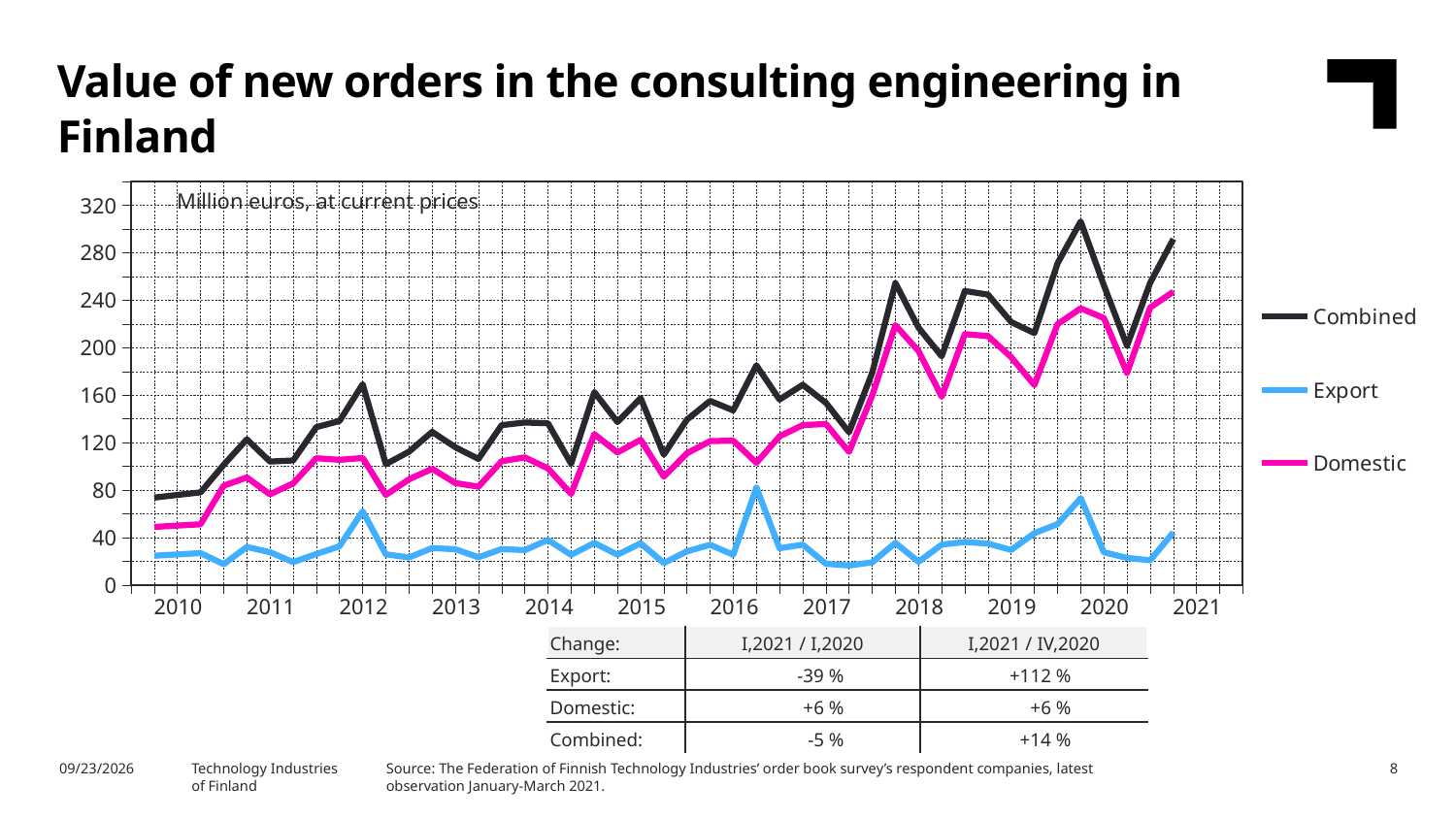
What unit is stated at the top of the chart? Million euros, at current prices How many series does the chart legend list? 3 Overall, does the Combined series rise or fall from 2010 to 2021? rise In 2018, which is larger, the Domestic series or the Export series? Domestic Is the value of the Combined series at the start of 2010 greater or less than 120? less Which series has the highest values throughout the chart? Combined Is the peak value of the Export series in 2016 greater or less than 60? greater Is the value of the Domestic series at the start of 2010 greater or less than 80? less Which series are listed in the chart legend? Combined, Export, Domestic What kind of chart is shown on the slide? line chart Which series has the lowest values throughout the chart? Export